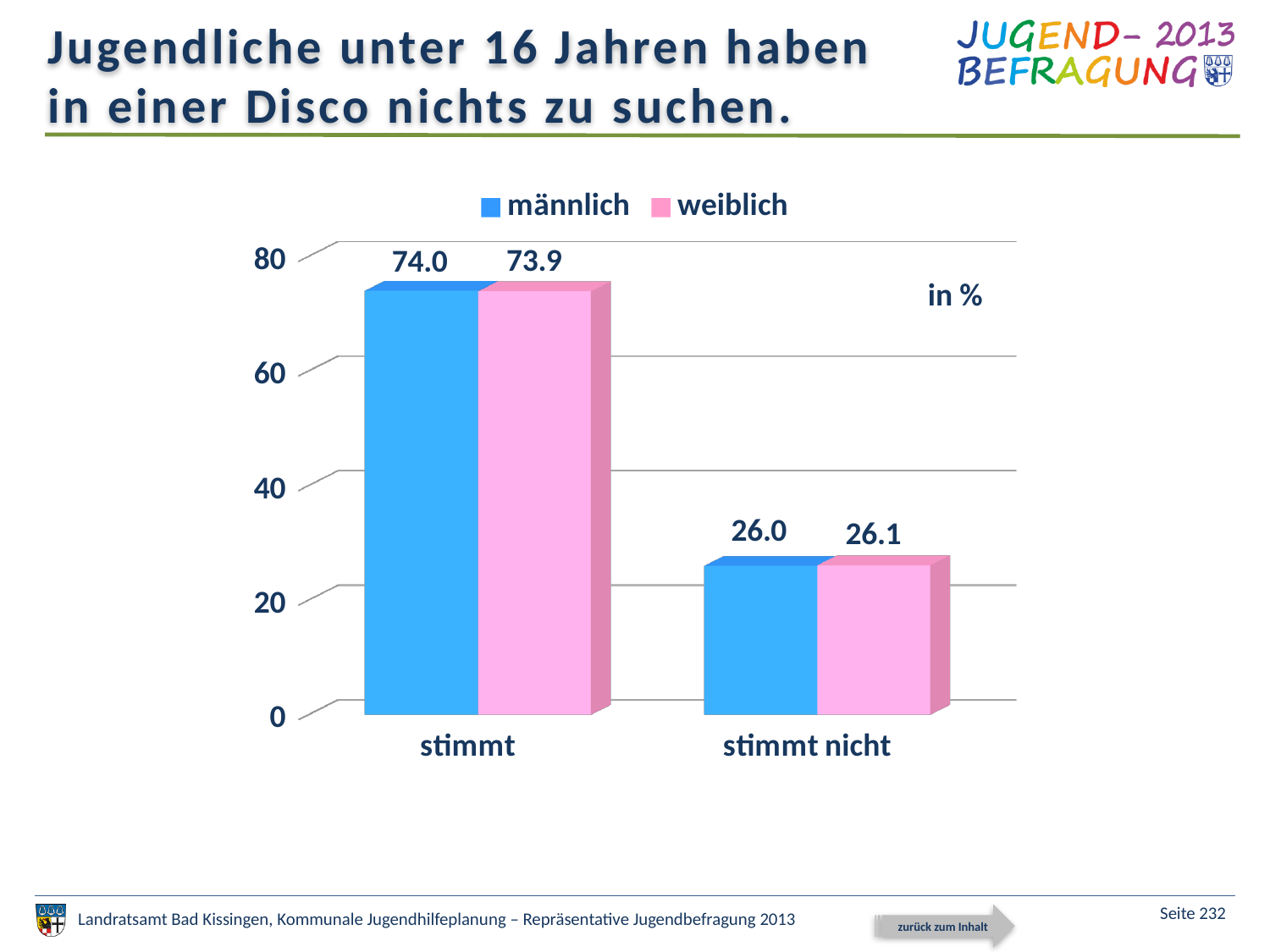
How many categories are shown on the x axis? 2 What is the value for männlich in the stimmt nicht category? 26.0 How many series does the legend list? 2 What kind of chart is shown on the slide? bar chart Is the männlich value for stimmt nicht greater or less than 40? less Which is larger: the weiblich value for stimmt or the weiblich value for stimmt nicht? stimmt Which category has the lowest value for weiblich? stimmt nicht What is the value for weiblich in the stimmt category? 73.9 What is the value for weiblich in the stimmt nicht category? 26.1 What is the difference between the männlich values for stimmt and stimmt nicht? 48.0 Which category has the highest value for männlich? stimmt What is the value for männlich in the stimmt category? 74.0